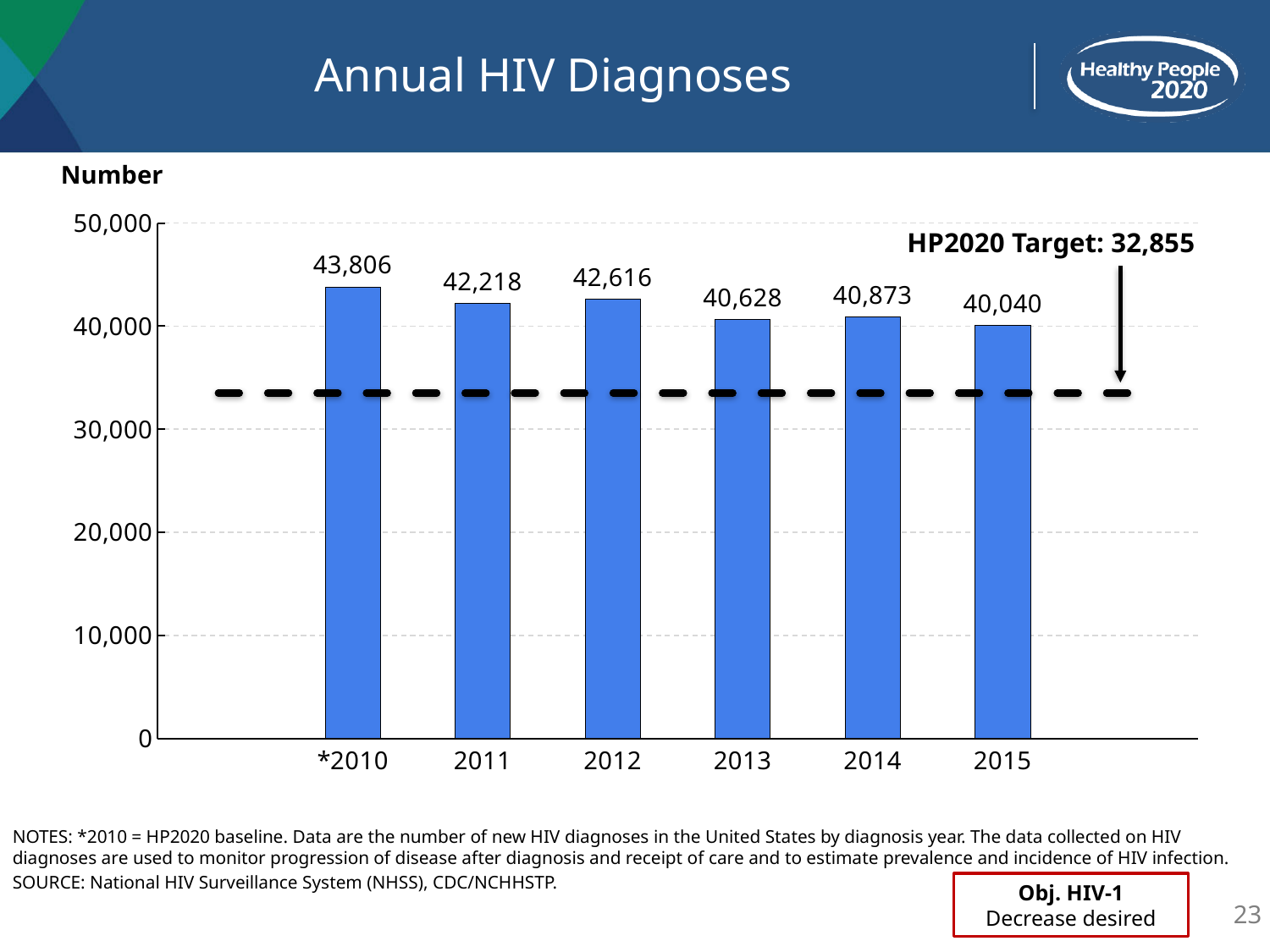
Which year has the highest number of annual HIV diagnoses? *2010 Is the value for 2014 greater or less than 30,000? greater Do the values generally rise or fall from *2010 to 2015? Fall What kind of chart is shown on the slide? Bar chart What is the number of annual HIV diagnoses shown for 2013? 40,628 How many years are plotted on the chart? 6 What is the HP2020 Target value shown on the chart? 32,855 Which year has more HIV diagnoses, 2011 or 2012? 2012 What is the difference between the number of HIV diagnoses in *2010 and in 2015? 3,766 What is the difference between the 2012 value and the 2011 value? 398 Which year has the lowest number of annual HIV diagnoses? 2015 What is the number of annual HIV diagnoses shown for 2015? 40,040